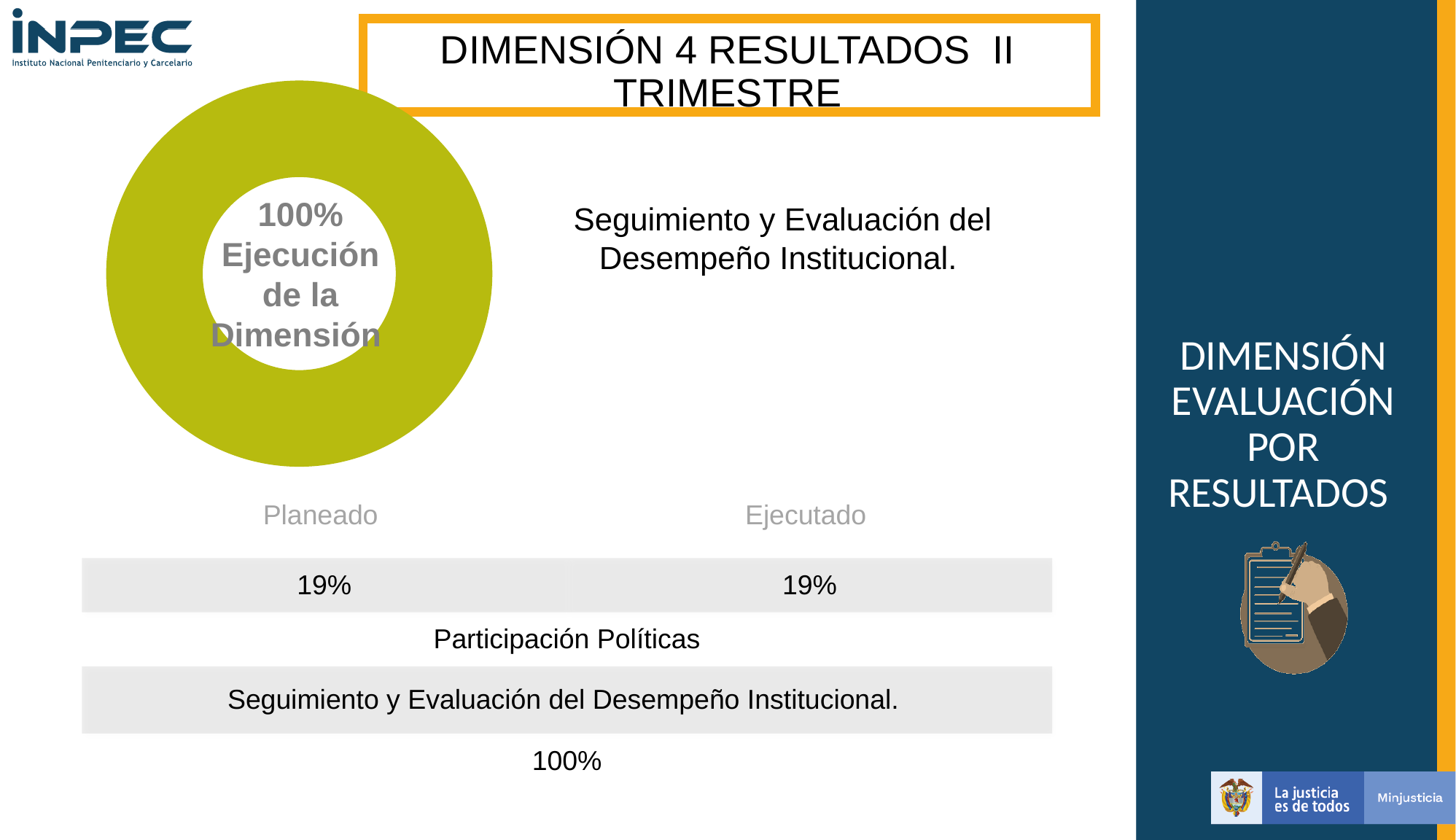
How many slices does the donut chart contain? 1 What text is written in the centre of the donut chart? 100% Ejecución de la Dimensión What percentage is shown in the centre of the donut chart? 100% What share of the donut chart does the single slice occupy? 100% What kind of chart is shown on the left of the slide? Donut (pie) chart What colour is the ring of the donut chart? Olive / yellow-green Is the value shown in the donut chart greater or less than 50%? greater